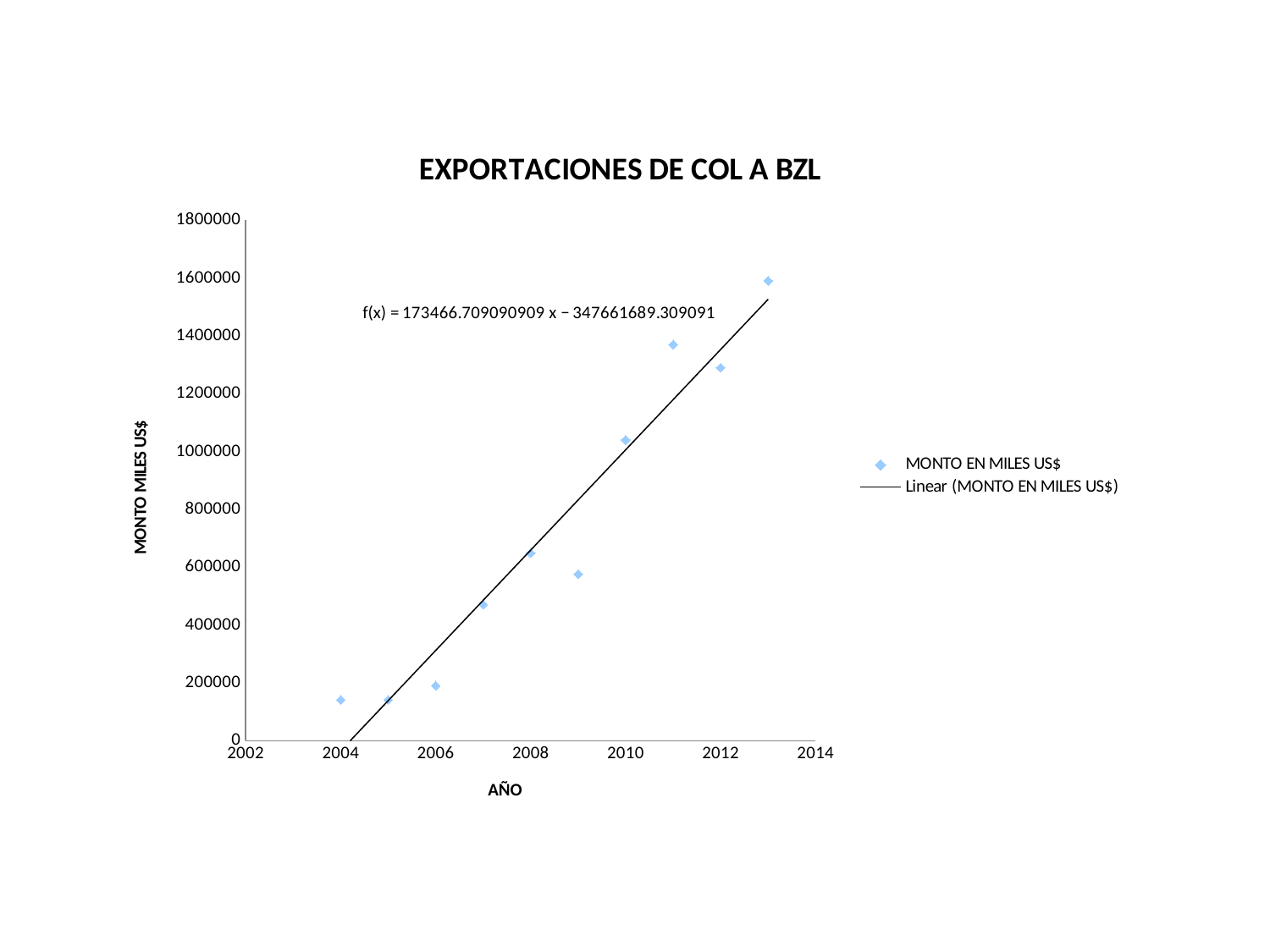
Which year has the larger value, 2011 or 2012? 2011 What is the label of the x axis? AÑO How many data points are plotted in the chart? 10 Is the value for 2009 greater or less than 600000? less Is the value for 2010 greater or less than 1000000? greater What is the title of the chart? EXPORTACIONES DE COL A BZL Is the value for 2013 greater or less than 1400000? greater What kind of chart is shown on the slide? scatter chart Do the values generally rise or fall from 2004 to 2013? rise How many entries does the legend list? 2 Which year has the highest value for MONTO EN MILES US$? 2013